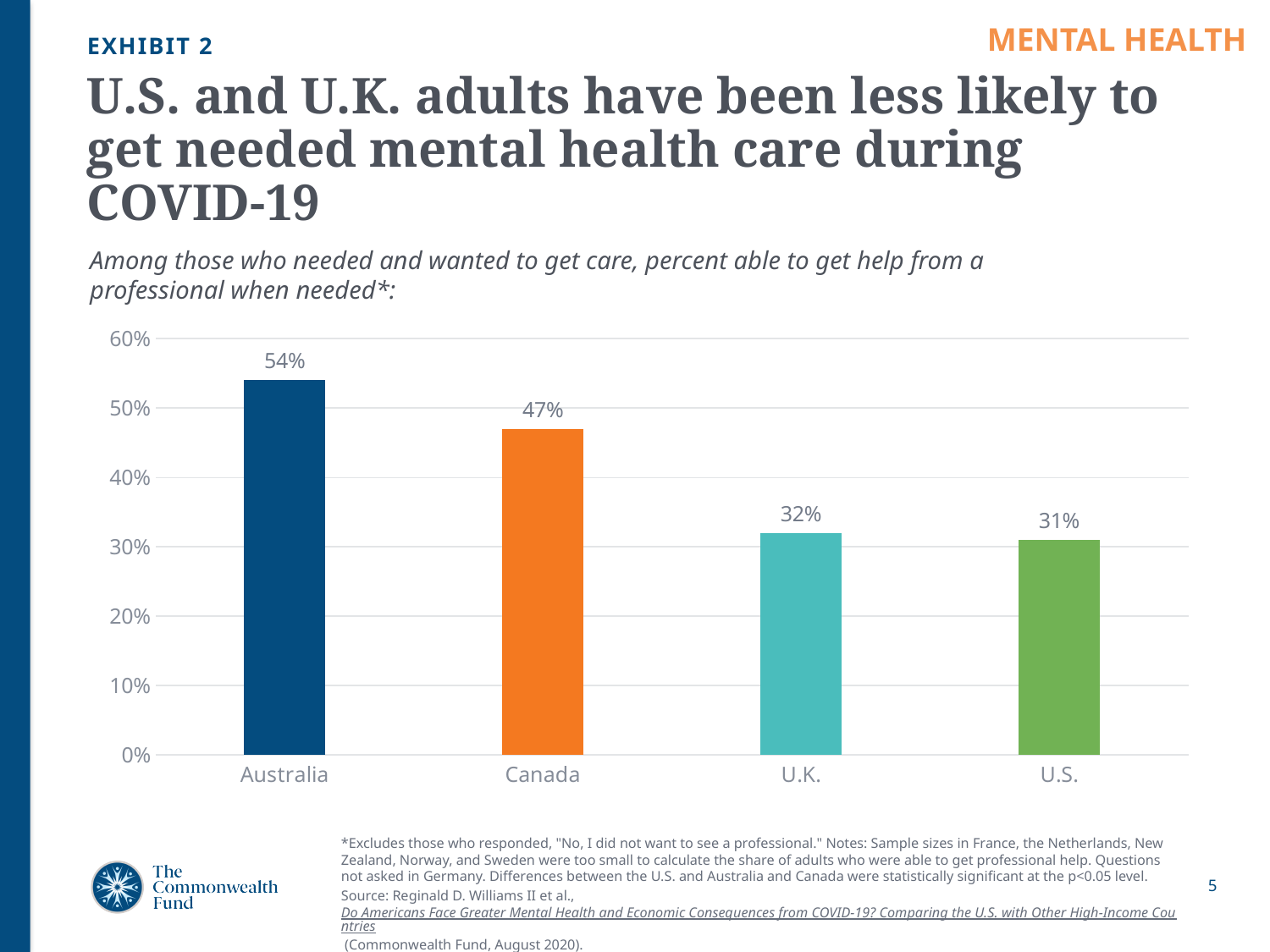
Which country has the highest percentage of adults able to get professional help when needed? Australia What is the difference in percentage points between Australia and the U.S.? 23 percentage points What type of chart is shown on the slide? Bar chart Which country has the lowest percentage of adults able to get professional help when needed? U.S. What is the value shown for the U.K.? 32% What is the difference between Canada's value and the U.K.'s value? 15 percentage points Which is larger, the value for Australia or the value for Canada? Australia What is the value shown for the U.S.? 31% What percent of adults in Australia were able to get help from a professional when needed? 54% What is the value shown for Canada? 47% How many countries are shown in the chart? 4 What is the highest value labeled on the vertical axis? 60%